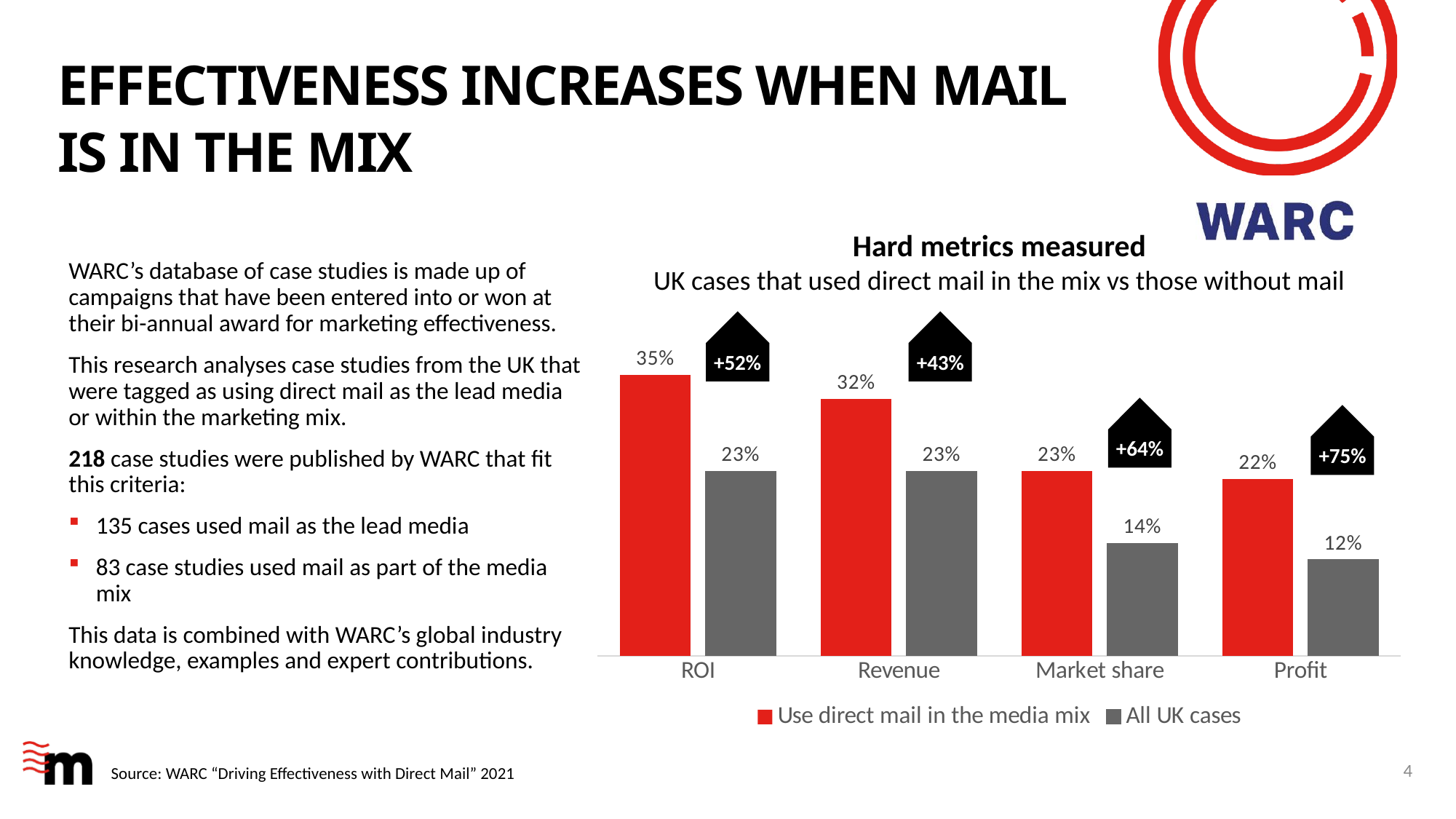
What type of chart is shown on the slide? Bar chart What is the value for Revenue in the 'Use direct mail in the media mix' series? 32% What is the difference between the 'Use direct mail in the media mix' and 'All UK cases' values for Profit? 10% For Market share, which series has the larger value: 'Use direct mail in the media mix' or 'All UK cases'? Use direct mail in the media mix What is the value for Profit in the 'All UK cases' series? 12% How many categories are shown on the x axis of the chart? 4 Which category has the highest value in the 'Use direct mail in the media mix' series? ROI What is the difference between the 'Use direct mail in the media mix' and 'All UK cases' values for ROI? 12% Which category has the lowest value in the 'All UK cases' series? Profit What is the value for ROI in the 'Use direct mail in the media mix' series? 35% What is the value for Market share in the 'All UK cases' series? 14% How many series does the chart legend list? 2